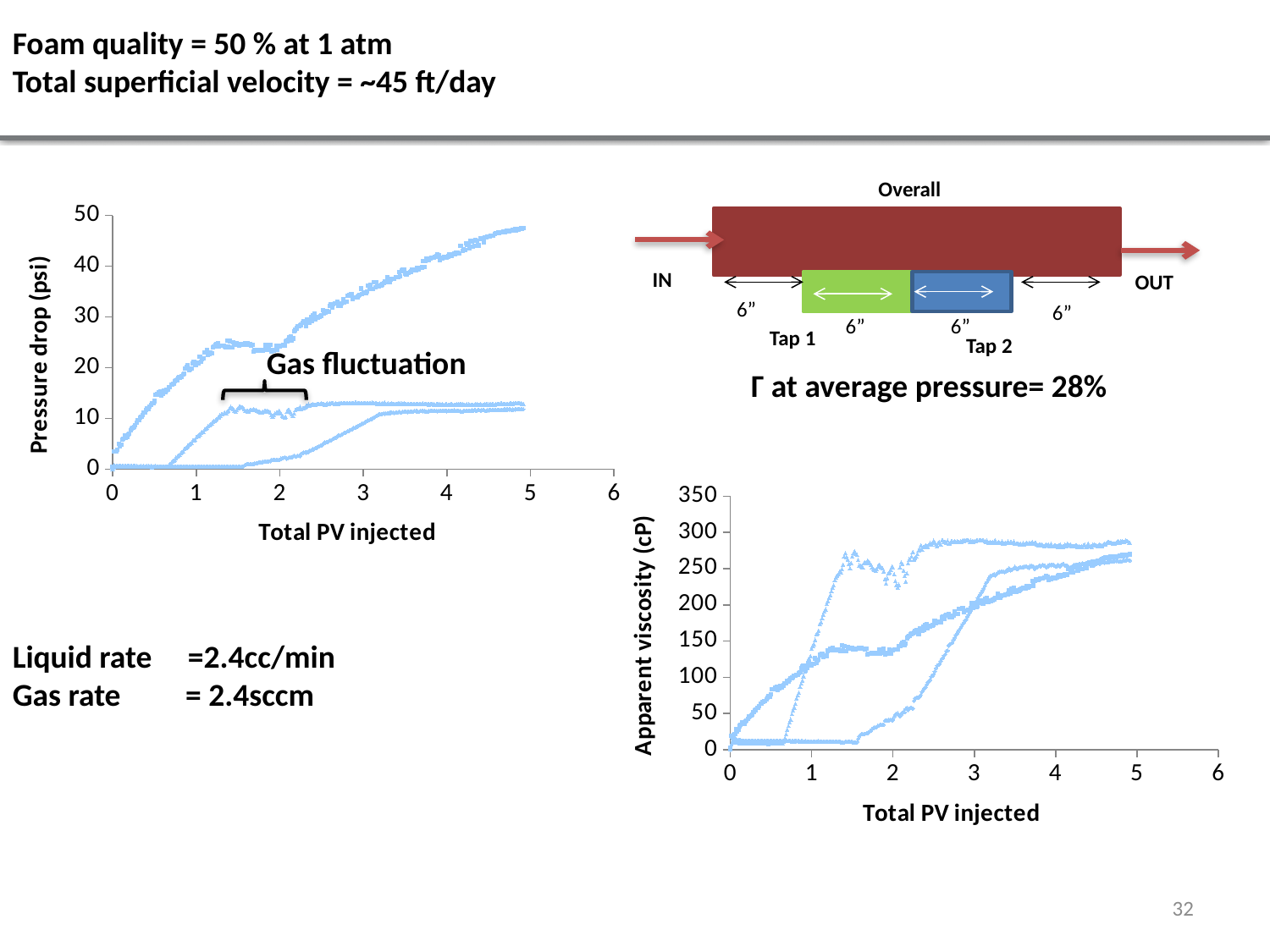
In the apparent viscosity chart, does the lowest curve rise or fall as Total PV injected increases from 2 to 3? rise In the pressure drop chart, does the highest curve generally rise or fall as Total PV injected increases from 2 to 5? rise In the pressure drop chart, what is the highest value shown on the y axis? 50 In the pressure drop chart, is the value of the lowest curve at 1 PV injected greater or less than 10? less In the pressure drop chart, what is the highest value shown on the x axis? 6 What kind of chart is the pressure drop chart on the left of the slide? Scatter (line) chart In the apparent viscosity chart, what is the label of the x axis? Total PV injected In the apparent viscosity chart, is the value of the lowest curve at 1 PV injected greater or less than 50? less In the apparent viscosity chart, what is the highest value shown on the y axis? 350 In the pressure drop chart, is the value of the highest curve at 5 PV injected greater or less than 40? greater In the pressure drop chart, what is the label of the y axis? Pressure drop (psi)